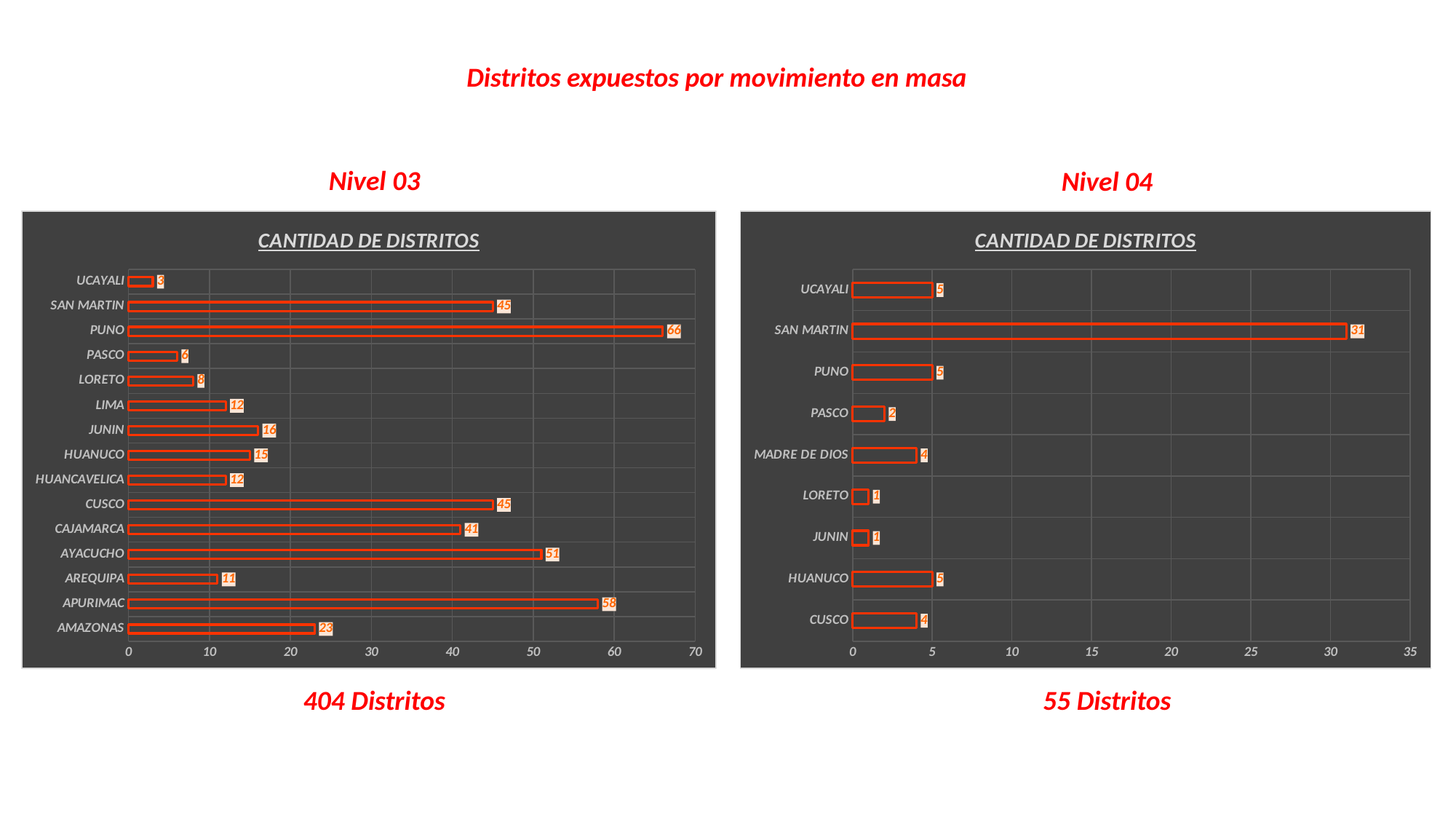
In the Nivel 04 chart on the right, which category has the highest value? SAN MARTIN In the Nivel 03 chart on the left, which is larger, the value for CAJAMARCA or the value for AMAZONAS? CAJAMARCA In the Nivel 03 chart on the left, which category has the lowest value? UCAYALI How many categories are shown in the Nivel 04 chart on the right? 9 In the Nivel 03 chart on the left, is the value for APURIMAC greater or less than 50? greater In the Nivel 04 chart on the right, what is the value for SAN MARTIN? 31 What kind of chart is the Nivel 04 chart on the right? Bar chart How many categories are shown in the Nivel 03 chart on the left? 15 In the Nivel 04 chart on the right, what is the difference between the values for SAN MARTIN and HUANUCO? 26 In the Nivel 03 chart on the left, what is the difference between the values for APURIMAC and AYACUCHO? 7 In the Nivel 03 chart on the left, which category has the highest value? PUNO In the Nivel 03 chart on the left, what is the value for PUNO? 66